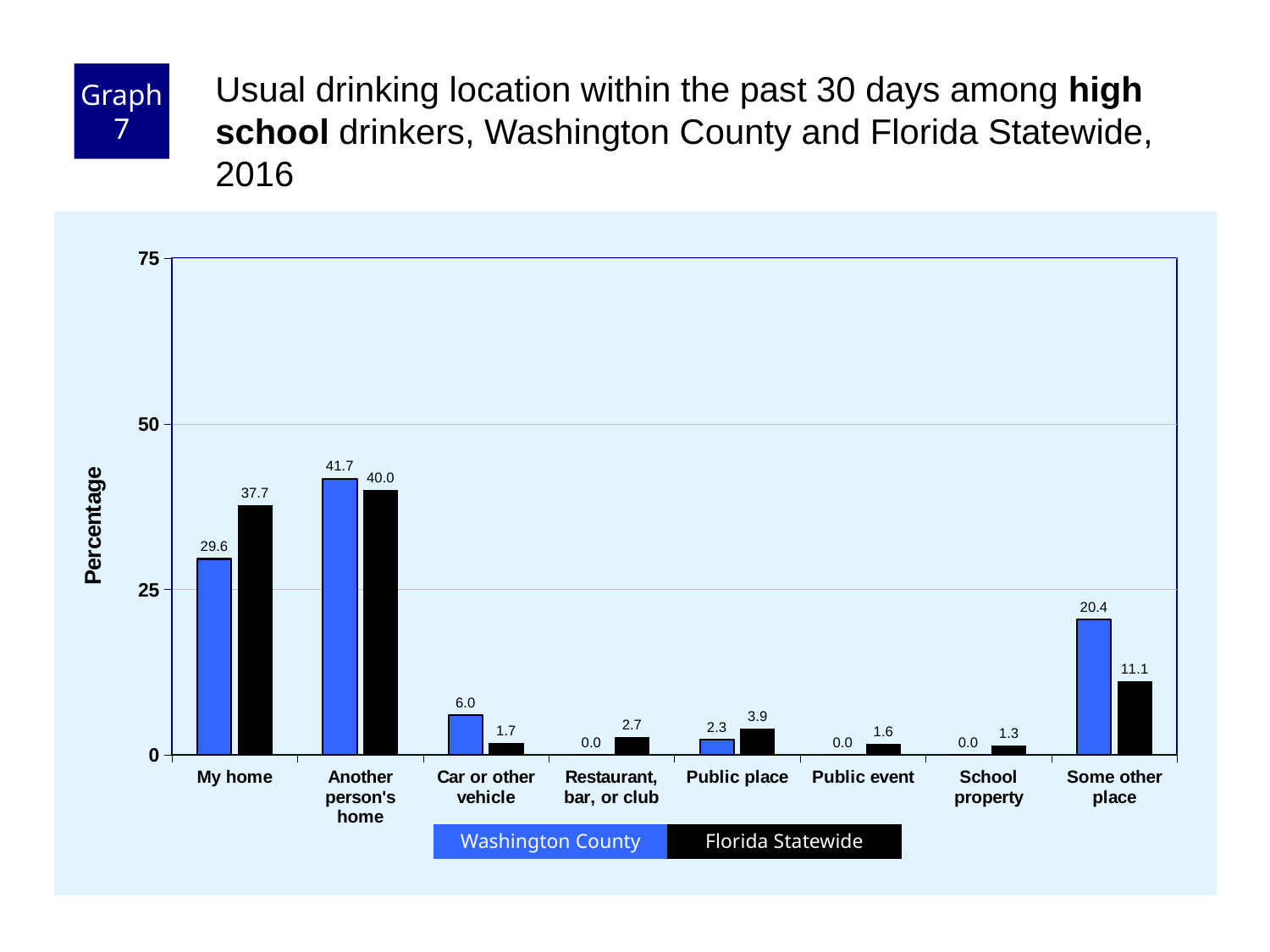
What is the Washington County value for "Car or other vehicle"? 6.0 For "Public place", which is larger: Washington County or Florida Statewide? Florida Statewide What is the difference between the Washington County and Florida Statewide values for "Some other place"? 9.3 What kind of chart is shown on the slide? Bar chart How many series does the legend list? 2 Which category has the highest Washington County value? Another person's home Is the Florida Statewide value for "Another person's home" greater or less than 25? greater Which category has the lowest Florida Statewide value? School property What is the Washington County value for "My home"? 29.6 How many categories are shown on the x axis? 8 What is the Florida Statewide value for "Some other place"? 11.1 What is the difference between the Florida Statewide and Washington County values for "My home"? 8.1